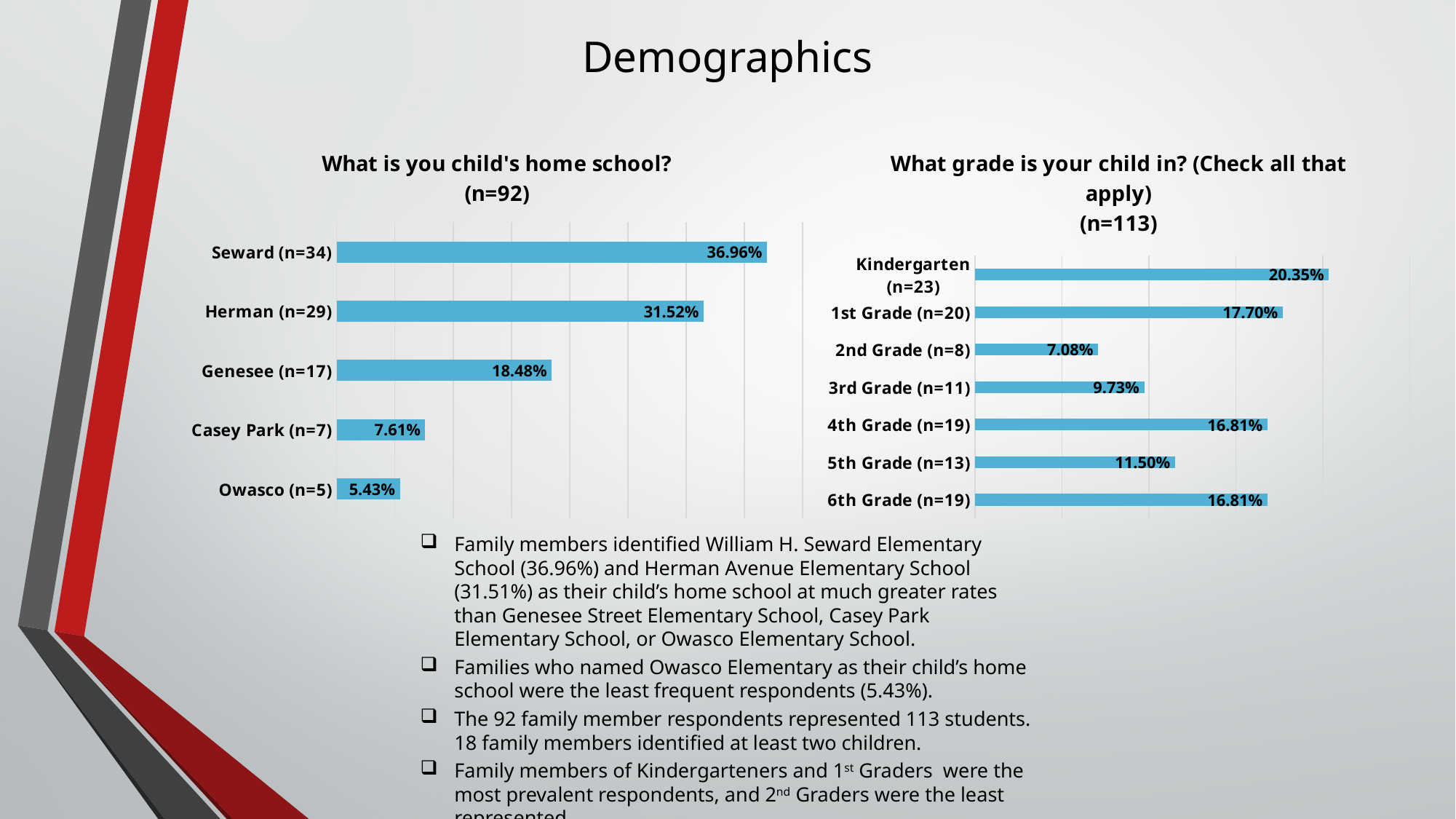
What type of chart is the 'What grade is your child in?' chart? Bar chart In the 'What grade is your child in?' chart, how many grade categories are shown? 7 In the 'What is you child's home school?' chart, which is larger: Genesee or Casey Park? Genesee In the 'What is you child's home school?' chart, what is the difference between the Seward and Herman percentages? 5.44% In the 'What grade is your child in?' chart, which grade has the highest percentage? Kindergarten (n=23) In the 'What is you child's home school?' chart, which school has the lowest percentage? Owasco (n=5) What is the sample size (n) shown in the title of the 'What is you child's home school?' chart? n=92 In the 'What grade is your child in?' chart, what is the difference between Kindergarten and 1st Grade percentages? 2.65% In the 'What grade is your child in?' chart, what percentage is shown for 3rd Grade (n=11)? 9.73% In the 'What is you child's home school?' chart, how many schools are listed? 5 In the 'What grade is your child in?' chart, which grade has the lowest percentage? 2nd Grade (n=8) In the 'What is you child's home school?' chart, what percentage is shown for Seward (n=34)? 36.96%